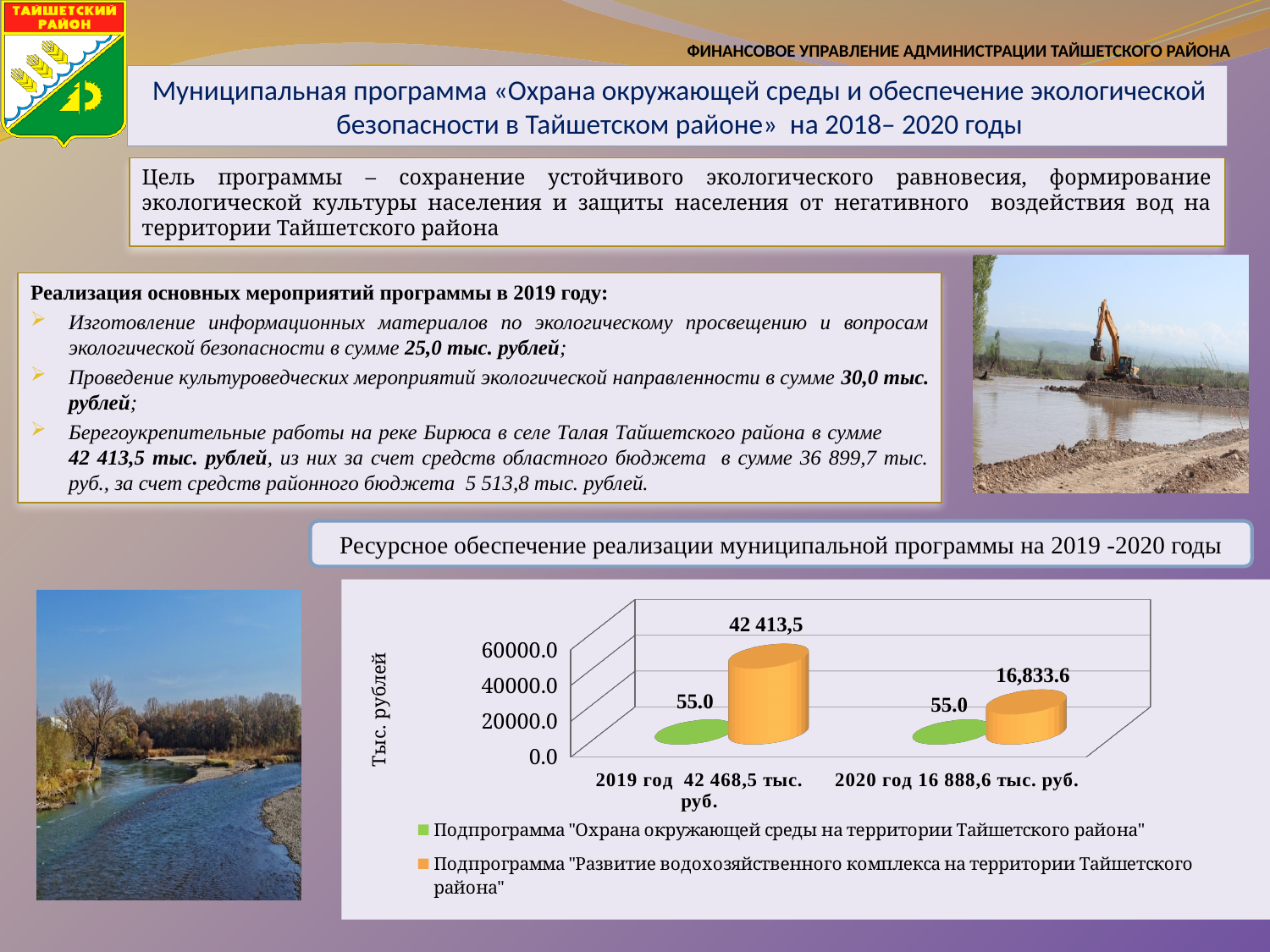
How many year categories are shown on the x axis of the chart? 2 Is the 2019 value for the 'Развитие водохозяйственного комплекса' subprogram greater or less than 40000.0? greater How many series does the chart legend list? 2 In which year is the 'Развитие водохозяйственного комплекса' subprogram value highest? 2019 год What is the label of the vertical axis of the chart? Тыс. рублей What is the value of the 'Развитие водохозяйственного комплекса' subprogram for 2020? 16,833.6 Which subprogram has the larger value in 2020? Подпрограмма "Развитие водохозяйственного комплекса на территории Тайшетского района" What is the value of the 'Охрана окружающей среды' subprogram for 2019? 55.0 Is the 2020 value for the 'Развитие водохозяйственного комплекса' subprogram greater or less than 20000.0? less What is the value of the 'Развитие водохозяйственного комплекса' subprogram for 2019? 42 413,5 What kind of chart is shown on the slide? Bar chart What is the value of the 'Охрана окружающей среды' subprogram for 2020? 55.0